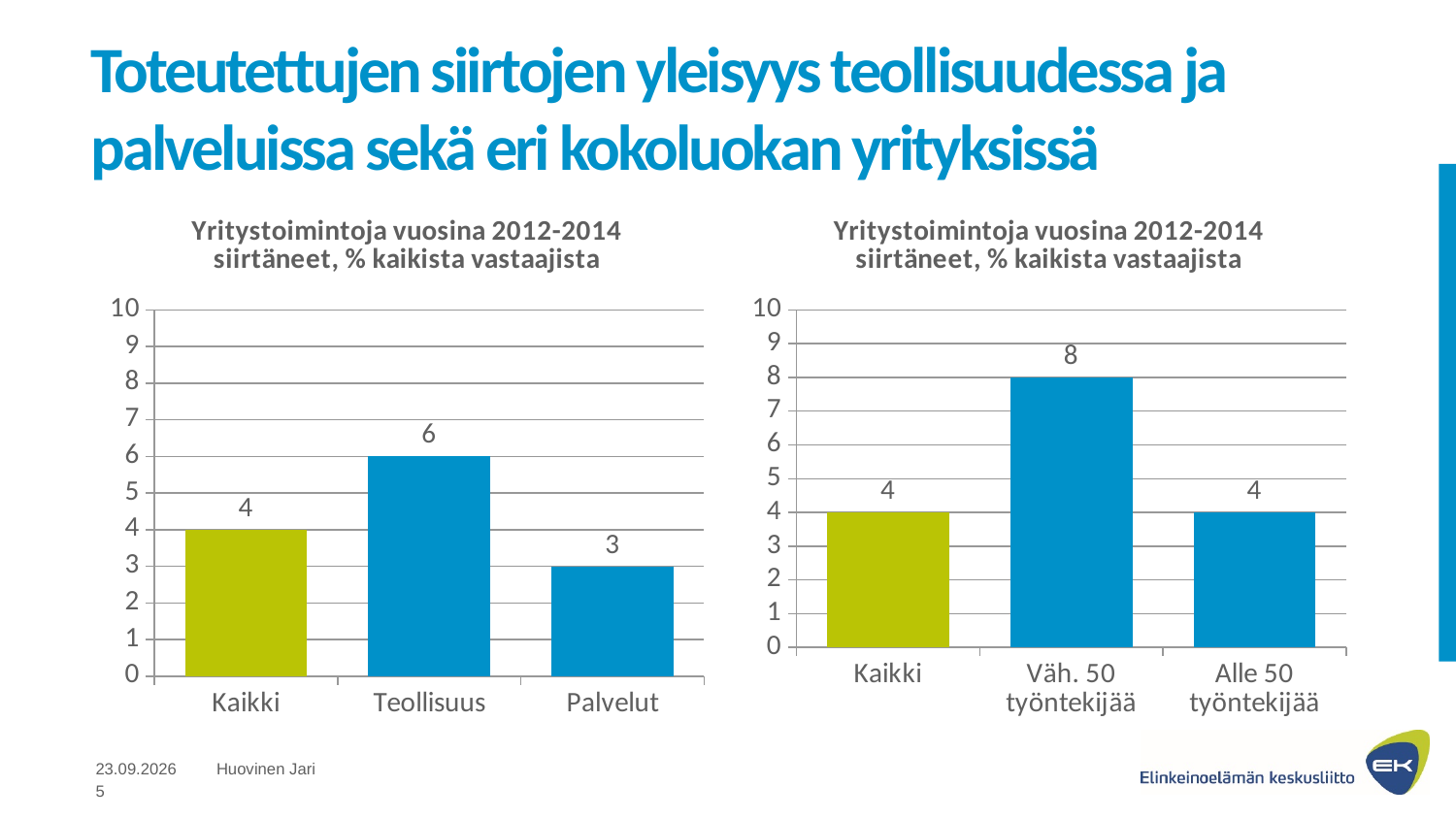
In the left chart, which category has the lowest value? Palvelut What type of chart is the left chart? Bar chart In the left chart, what is the value for Teollisuus? 6 In the right chart, what is the difference between the values for Väh. 50 työntekijää and Kaikki? 4 In the left chart, what is the difference between the values for Teollisuus and Palvelut? 3 In the right chart, what is the value for Alle 50 työntekijää? 4 In the left chart, what is the value for Palvelut? 3 How many categories are shown in the right chart? 3 In the left chart, which is larger, the value for Kaikki or the value for Palvelut? Kaikki In the left chart, which category has the highest value? Teollisuus In the right chart, what is the value for Väh. 50 työntekijää? 8 In the right chart, which category has the highest value? Väh. 50 työntekijää